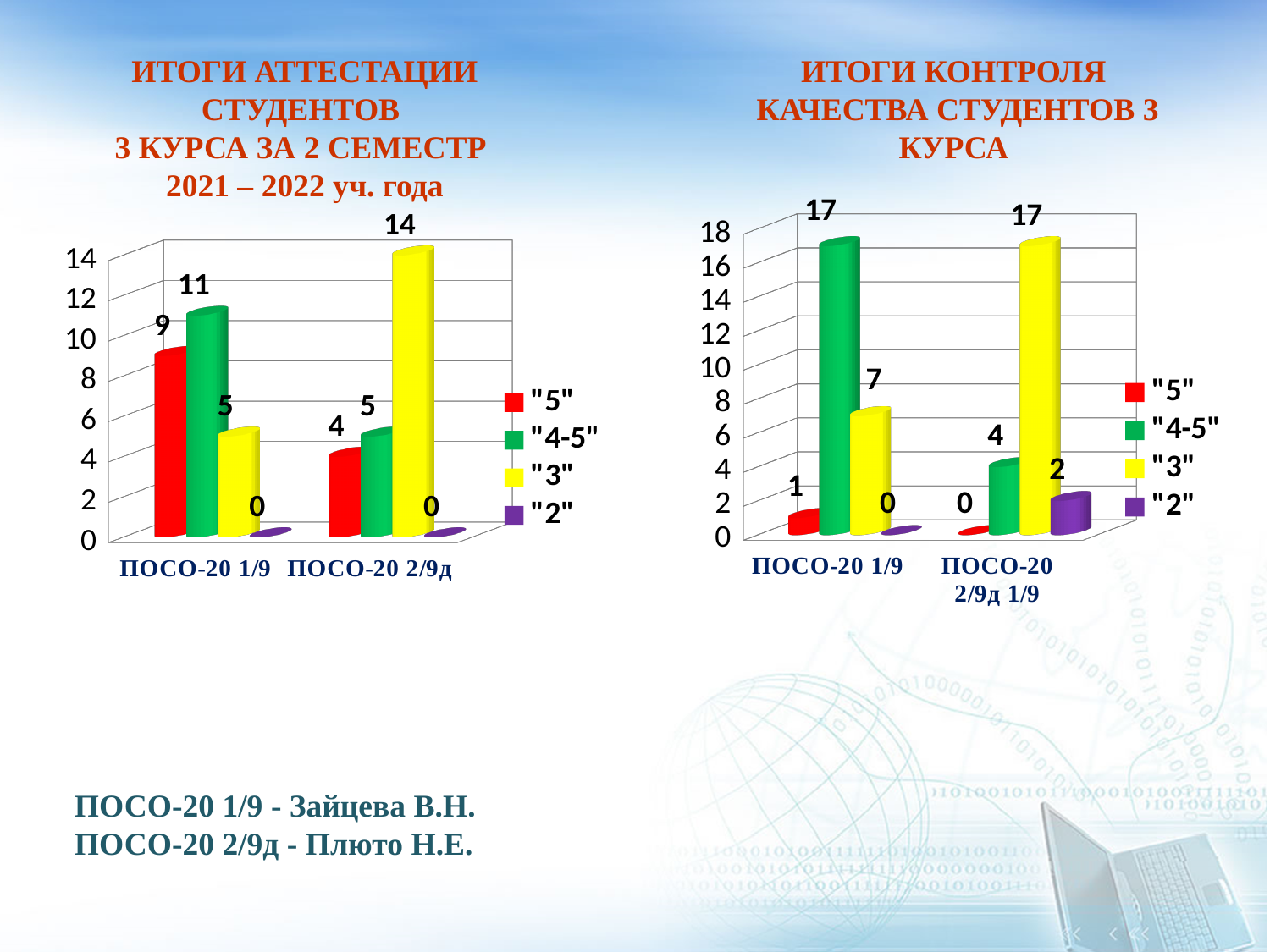
In the left chart (ИТОГИ АТТЕСТАЦИИ СТУДЕНТОВ 3 КУРСА), which series has the highest value for ПОСО-20 1/9? "4-5" In the left chart (ИТОГИ АТТЕСТАЦИИ СТУДЕНТОВ 3 КУРСА), how many series does the legend list? 4 In the right chart (ИТОГИ КОНТРОЛЯ КАЧЕСТВА СТУДЕНТОВ 3 КУРСА), which series has the lowest value for ПОСО-20 1/9? "2" In the right chart (ИТОГИ КОНТРОЛЯ КАЧЕСТВА СТУДЕНТОВ 3 КУРСА), what is the value of the "4-5" series for ПОСО-20 1/9? 17 In the right chart (ИТОГИ КОНТРОЛЯ КАЧЕСТВА СТУДЕНТОВ 3 КУРСА), is the "3" value larger for ПОСО-20 1/9 or for ПОСО-20 2/9д 1/9? ПОСО-20 2/9д 1/9 In the right chart (ИТОГИ КОНТРОЛЯ КАЧЕСТВА СТУДЕНТОВ 3 КУРСА), what is the difference between the "3" value and the "4-5" value for ПОСО-20 1/9? 10 In the right chart (ИТОГИ КОНТРОЛЯ КАЧЕСТВА СТУДЕНТОВ 3 КУРСА), what is the value of the "2" series for ПОСО-20 2/9д 1/9? 2 In the left chart (ИТОГИ АТТЕСТАЦИИ СТУДЕНТОВ 3 КУРСА), what is the value of the "5" series for ПОСО-20 1/9? 9 In the left chart (ИТОГИ АТТЕСТАЦИИ СТУДЕНТОВ 3 КУРСА), what is the difference between the "4-5" values for ПОСО-20 1/9 and ПОСО-20 2/9д? 6 In the left chart (ИТОГИ АТТЕСТАЦИИ СТУДЕНТОВ 3 КУРСА), what kind of chart is shown? Bar chart In the right chart (ИТОГИ КОНТРОЛЯ КАЧЕСТВА СТУДЕНТОВ 3 КУРСА), how many categories are shown on the x axis? 2 In the left chart (ИТОГИ АТТЕСТАЦИИ СТУДЕНТОВ 3 КУРСА), what is the value of the "3" series for ПОСО-20 2/9д? 14